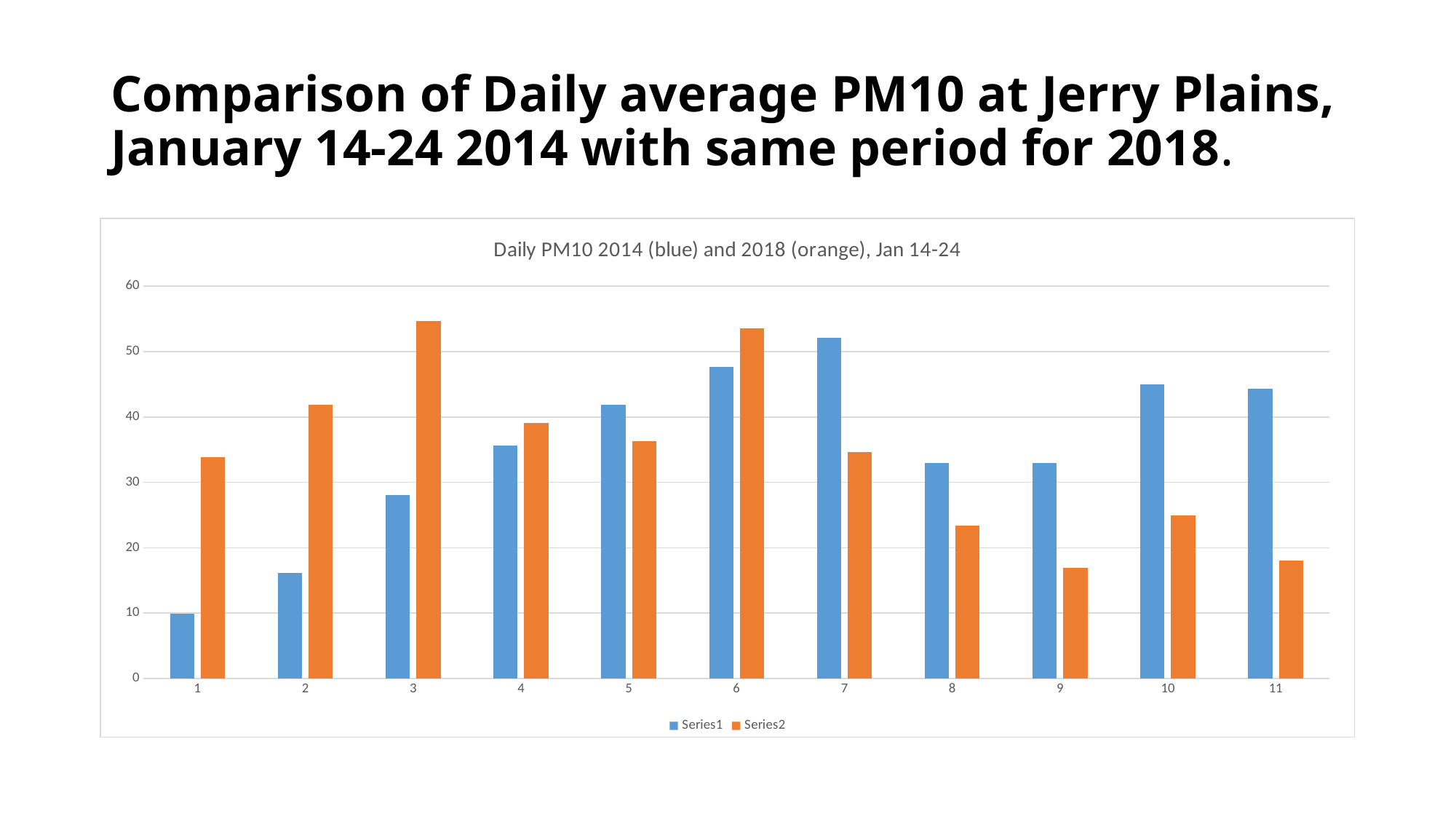
Which category has the lowest value for Series1? 1 Is the value for Series2 at category 3 greater or less than 50? greater What kind of chart is shown on the slide? bar chart How many categories are shown on the x axis? 11 At category 11, which series has the larger value, Series1 or Series2? Series1 How many series does the legend list? 2 Is the value for Series1 at category 7 greater or less than 50? greater At category 1, which series has the larger value, Series1 or Series2? Series2 What is the title of the chart? Daily PM10 2014 (blue) and 2018 (orange), Jan 14-24 Which category has the highest value for Series1? 7 Is the value for Series2 at category 9 greater or less than 20? less